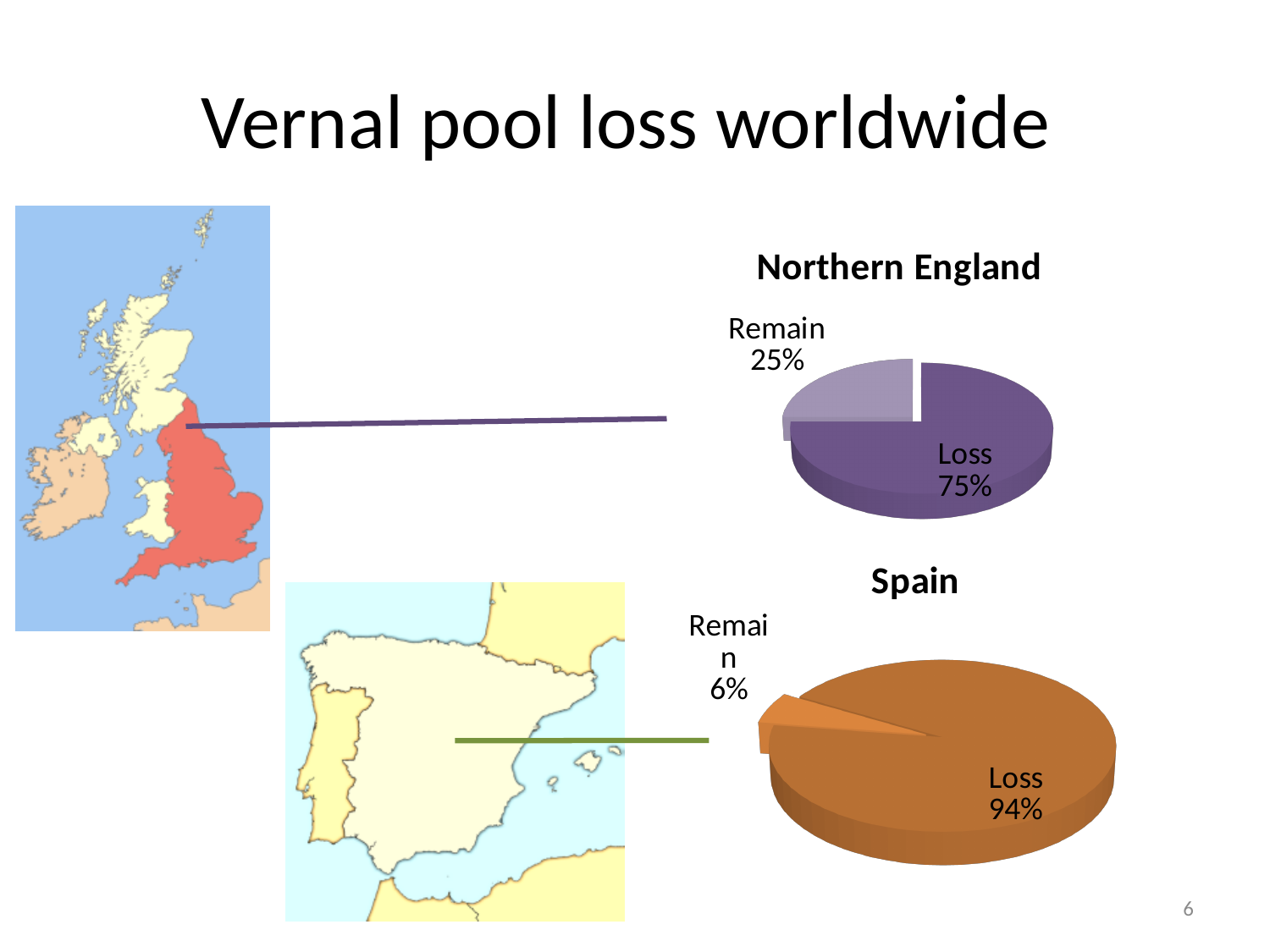
In the Northern England chart, what share of vernal pools is shown as Loss? 75% What is the difference between the Loss share in the Spain chart and the Loss share in the Northern England chart? 19% In the Northern England chart, what share is shown as Remain? 25% Which is larger: the Loss share in the Spain chart or the Loss share in the Northern England chart? Spain What is the title of the chart at the top right of the slide? Northern England In the Spain chart, which slice is the largest? Loss In the Spain chart, what share is shown as Loss? 94% What kind of chart is the Spain chart? Pie chart In the Northern England chart, which slice is the smallest? Remain How many slices does the Spain chart have? 2 In the Spain chart, what share is shown as Remain? 6% What kind of chart is the Northern England chart? Pie chart